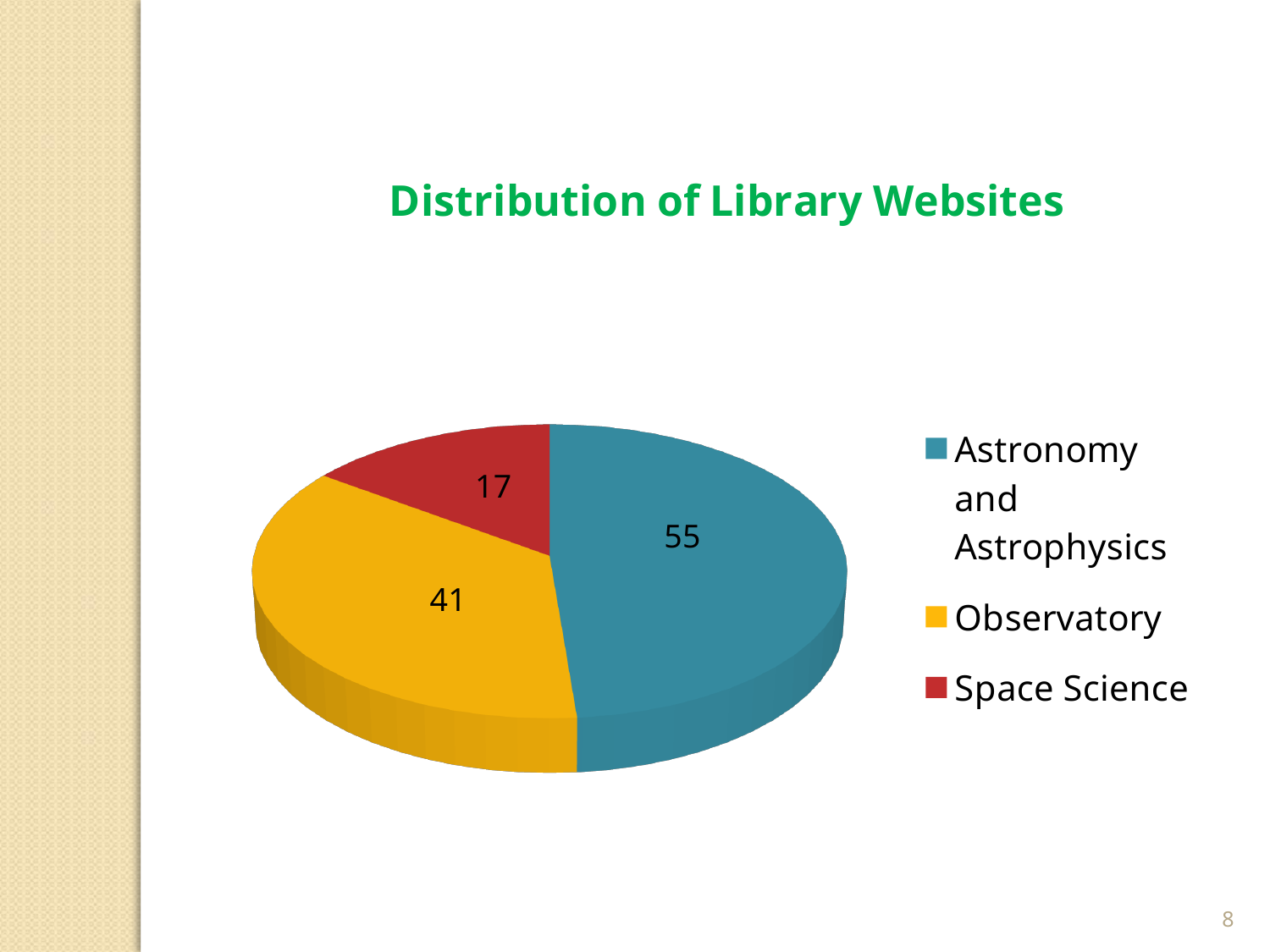
What is the value for Observatory? 41 Which category has the smallest slice of the pie? Space Science What is the total of all the values shown in the pie chart? 113 What is the value for Space Science? 17 Which is larger, the value for Observatory or the value for Space Science? Observatory Which category has the largest slice of the pie? Astronomy and Astrophysics What is the difference between the values for Astronomy and Astrophysics and Observatory? 14 What is the difference between the values for Observatory and Space Science? 24 What is the value for Astronomy and Astrophysics? 55 What type of chart is shown on the slide? pie chart What is the title of the chart? Distribution of Library Websites How many categories does the pie chart show? 3